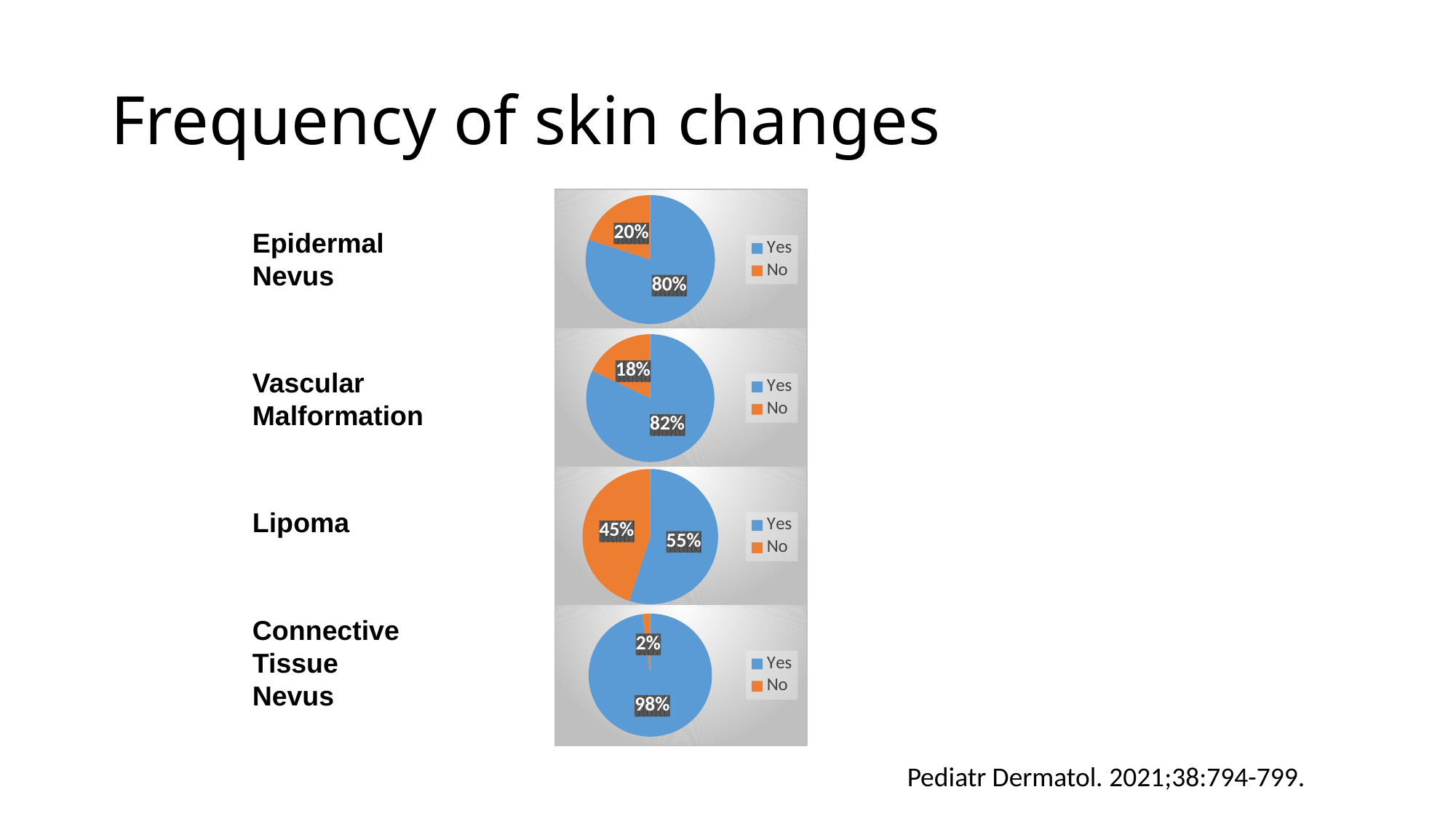
In the pie charts, which colour represents No? Orange In the Connective Tissue Nevus pie chart, what percentage is labelled for No? 2% What type of chart is used for each of the four skin changes on the slide? Pie chart In the Epidermal Nevus pie chart, what percentage is labelled for No? 20% In the Vascular Malformation pie chart, what percentage is labelled for Yes? 82% How many entries does the legend of each pie chart list? 2 How many pie charts are shown on the slide? 4 In the Connective Tissue Nevus pie chart, what percentage is labelled for Yes? 98% In the Lipoma pie chart, what is the difference between the Yes and No percentages? 10% In the Epidermal Nevus pie chart, what percentage is labelled for Yes? 80% In the Lipoma pie chart, which slice is larger, Yes or No? Yes In the Lipoma pie chart, what percentage is labelled for No? 45%